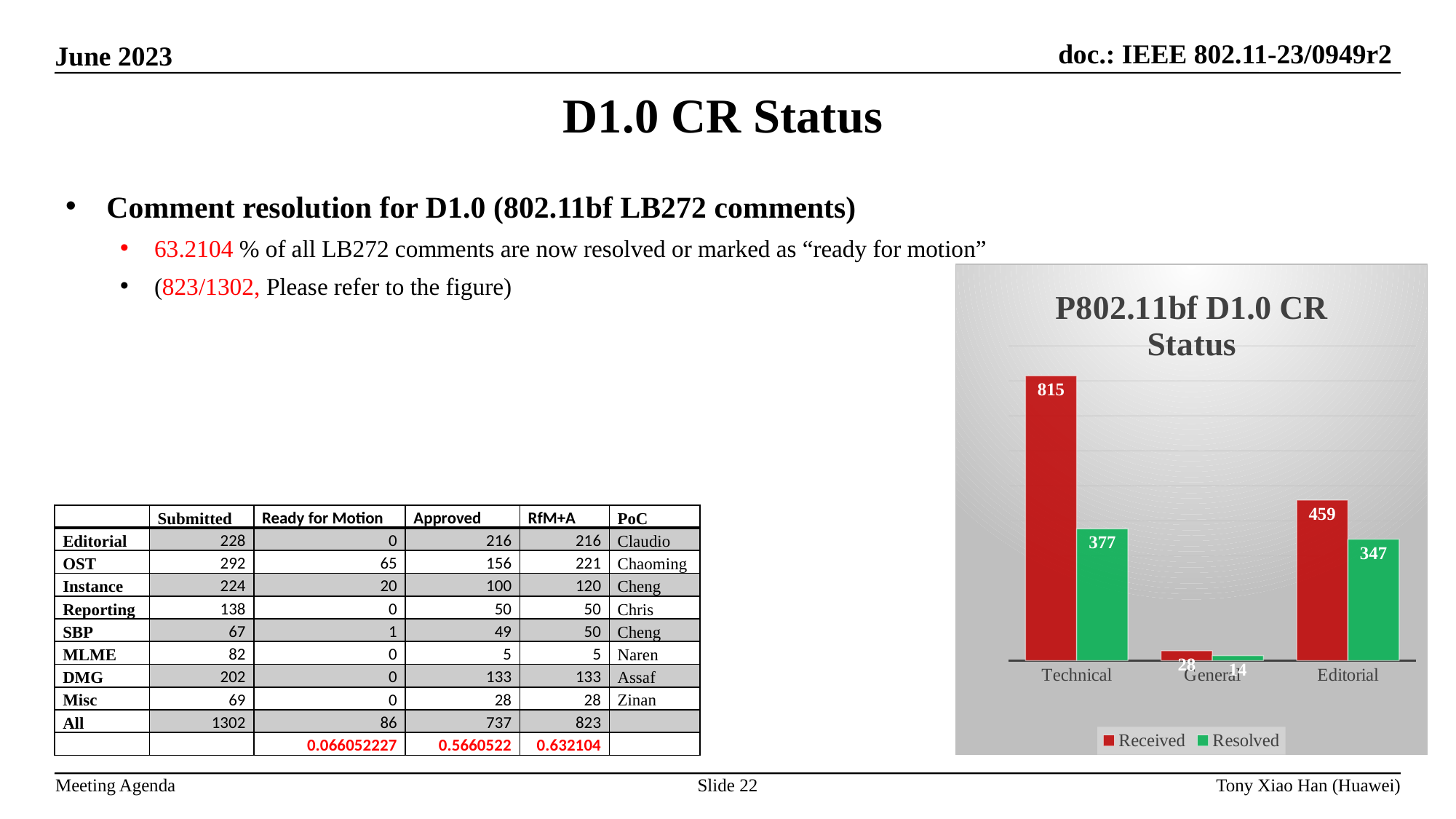
Which is larger, the Resolved value for Technical or the Resolved value for Editorial? Technical What is the difference between the Received and Resolved values for Editorial? 112 What is the Resolved value for Editorial? 347 Which category has the highest Received value? Technical How many series does the chart legend list? 2 What is the Received value for General? 28 What is the Received value for Technical? 815 What is the title of the chart? P802.11bf D1.0 CR Status Which category has the lowest Resolved value? General What type of chart is shown on the slide? bar chart What is the Resolved value for Technical? 377 How many categories are shown on the x axis of the chart? 3